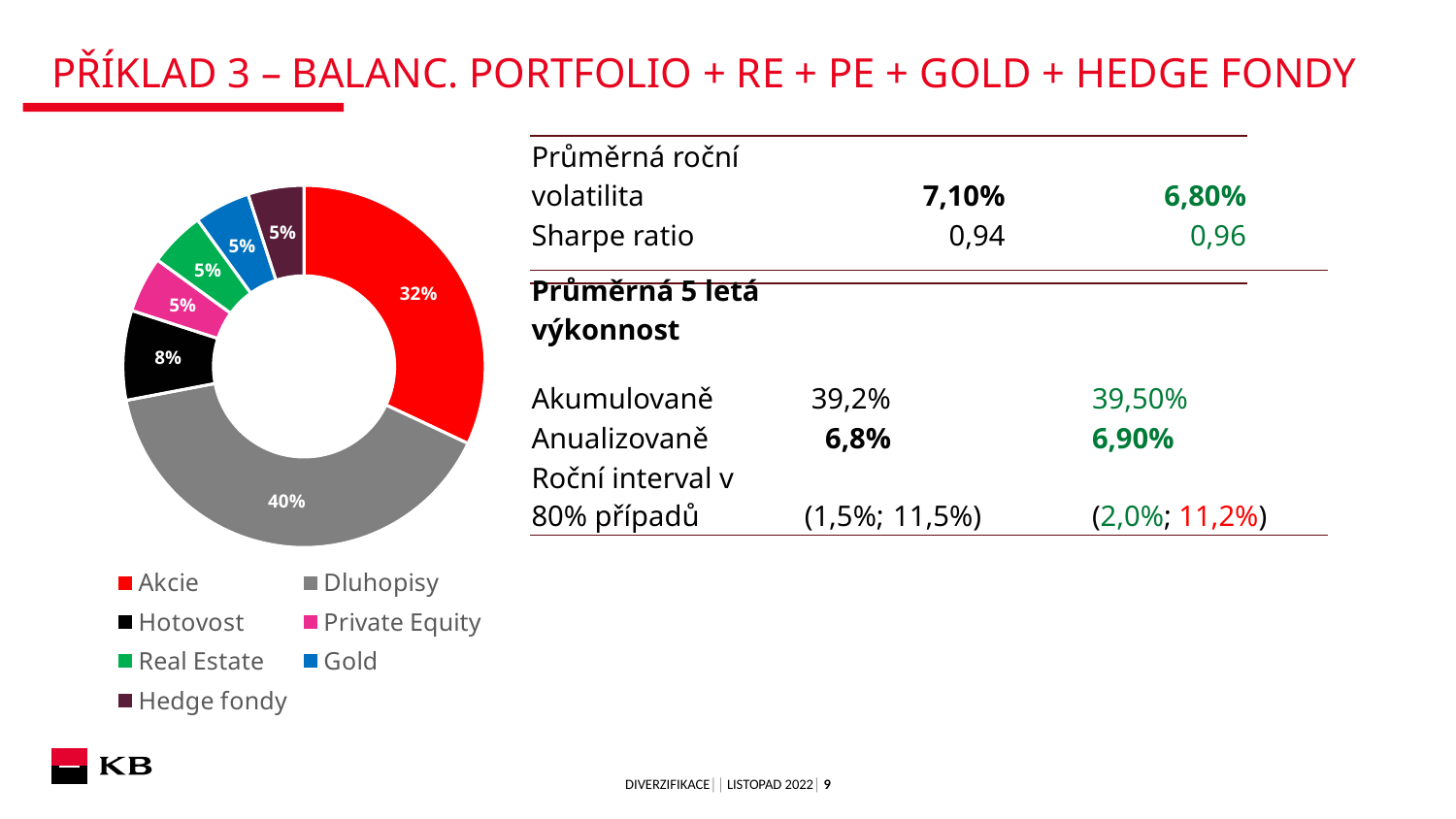
What share of the portfolio is Hotovost in the doughnut chart? 8% What is the difference in share between Dluhopisy and Akcie in the doughnut chart? 8% Which has a larger share in the doughnut chart, Hotovost or Private Equity? Hotovost What share of the portfolio is Akcie in the doughnut chart? 32% Which category has the largest share in the doughnut chart? Dluhopisy What is the difference in share between Akcie and Hotovost in the doughnut chart? 24% How many categories does the doughnut chart show? 7 What share of the portfolio is Dluhopisy in the doughnut chart? 40% Which colour represents Akcie in the doughnut chart? Red What type of chart is shown on the slide? Doughnut chart What is the combined share of Akcie and Dluhopisy in the doughnut chart? 72% What share of the portfolio is Gold in the doughnut chart? 5%